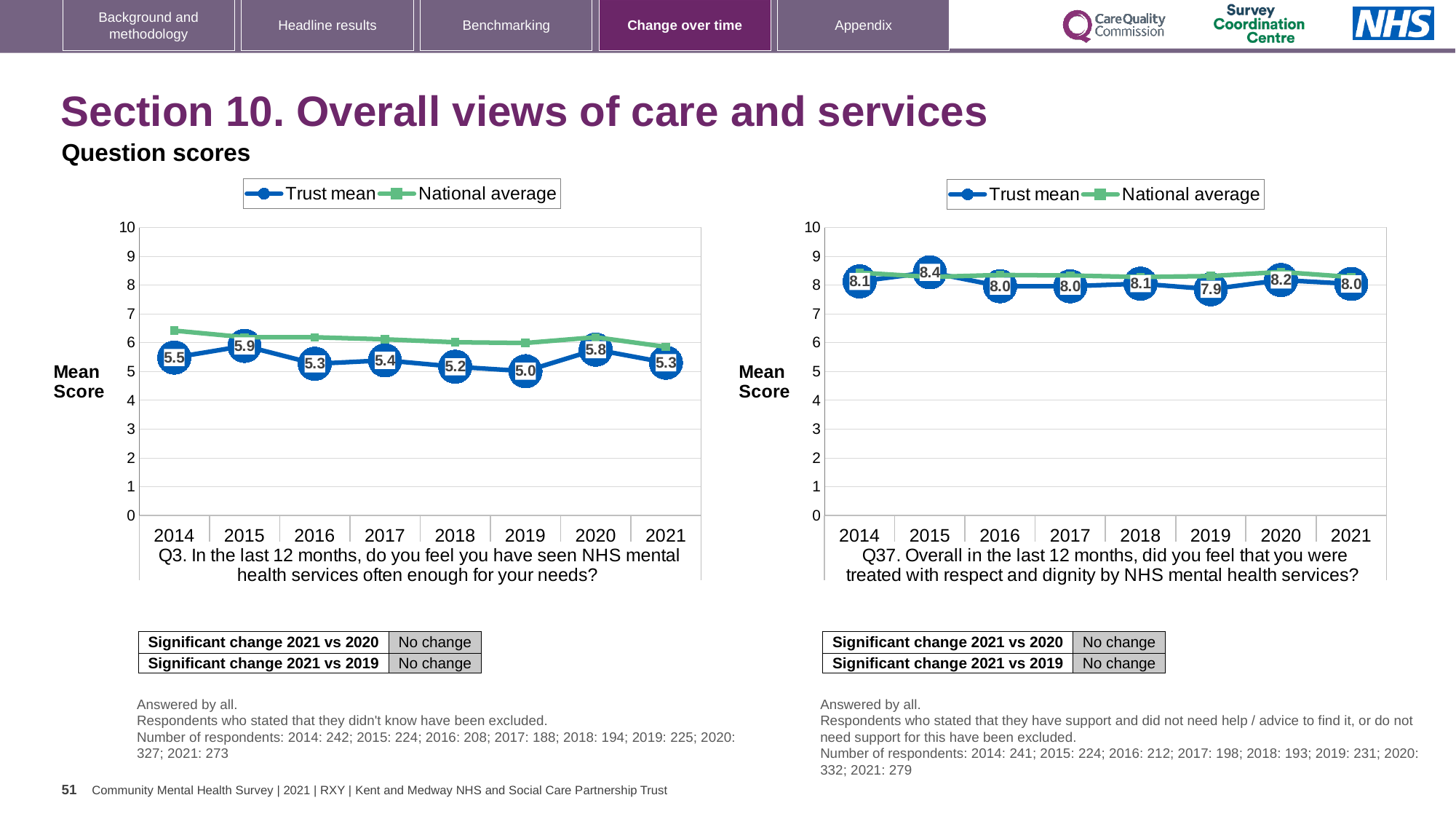
In the Q3 chart on the left, what is the Trust mean score for 2019? 5.0 In the Q37 chart on the right, which year has the lowest Trust mean score? 2019 In the Q3 chart on the left, which year has the lowest Trust mean score? 2019 In the Q37 chart on the right, what is the Trust mean score for 2015? 8.4 In the Q3 chart on the left, which year has the highest Trust mean score? 2015 In the Q37 chart on the right, what is the difference between the Trust mean scores for 2015 and 2019? 0.5 In the Q3 chart on the left, is the National average for 2014 greater or less than 6? greater What kind of chart is the Q3 chart on the left? Line chart How many years are plotted on the x axis of the Q37 chart on the right? 8 In the Q3 chart on the left, what is the difference between the Trust mean scores for 2020 and 2021? 0.5 In the Q37 chart on the right, which is larger, the Trust mean for 2020 or for 2021? 2020 How many series does the legend of the Q3 chart on the left list? 2